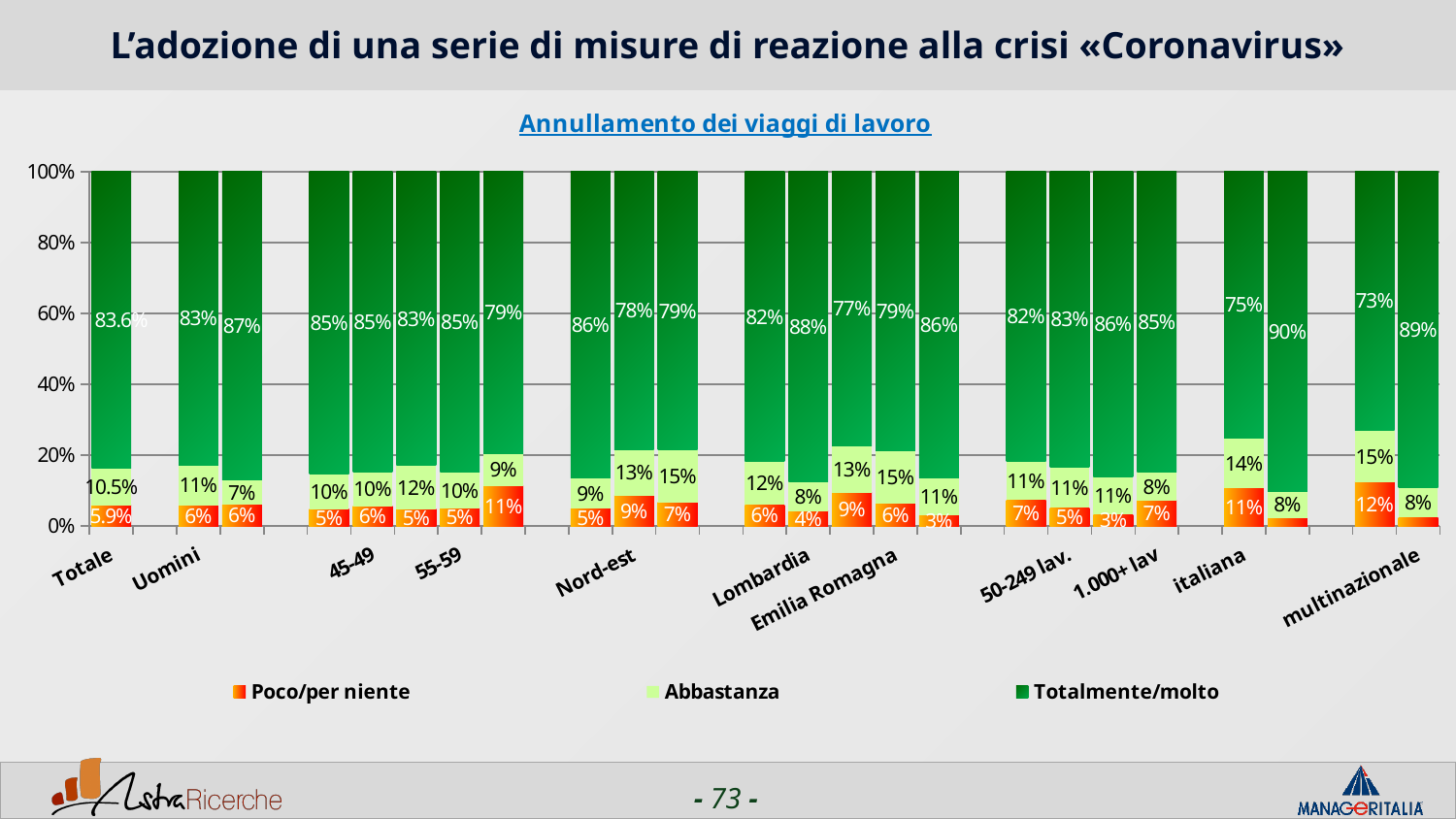
What is the 'Abbastanza' value for Uomini? 11% What is the 'Totalmente/molto' value for Totale? 83.6% Which legend entry is shown in dark green? Totalmente/molto How many series does the legend list? 3 What is the title of the chart? Annullamento dei viaggi di lavoro What is the 'Poco/per niente' value for Totale? 5.9% What type of chart is shown on the slide? stacked bar chart What is the 'Totalmente/molto' value for Uomini? 83% What is the difference between the 'Abbastanza' and 'Poco/per niente' values for Totale? 4.6 percentage points Is the 'Totalmente/molto' value for Totale greater or less than 80%? greater What is the 'Abbastanza' value for Totale? 10.5% For Uomini, which is larger: the 'Abbastanza' value or the 'Poco/per niente' value? Abbastanza